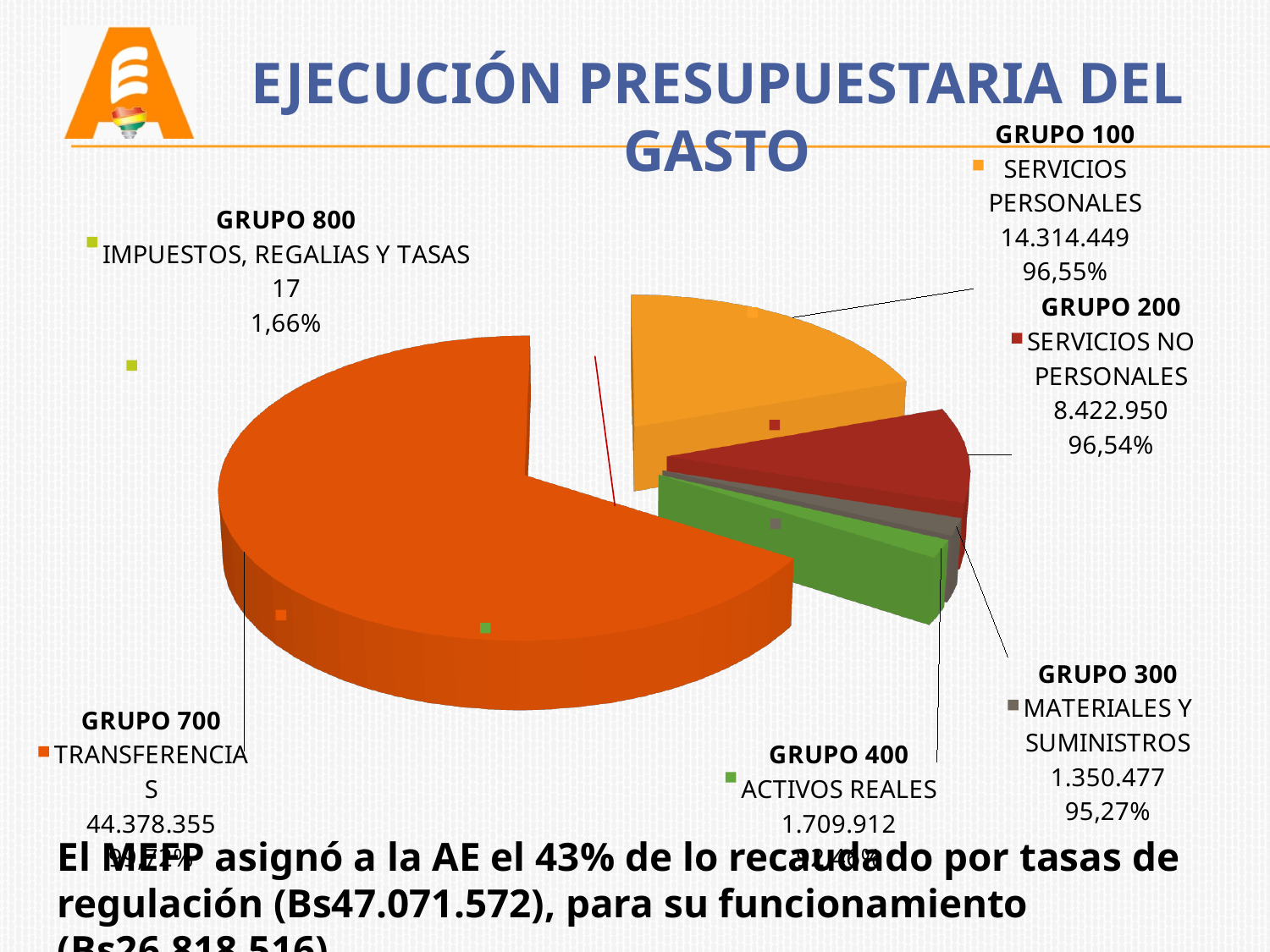
What amount is shown for GRUPO 200 SERVICIOS NO PERSONALES? 8.422.950 What percentage is shown for GRUPO 300 MATERIALES Y SUMINISTROS? 95,27% What amount is shown for GRUPO 300 MATERIALES Y SUMINISTROS? 1.350.477 Which group has the largest slice of the pie? GRUPO 700 TRANSFERENCIAS What kind of chart is shown on the slide? pie chart Which group has the smallest amount? GRUPO 800 IMPUESTOS, REGALIAS Y TASAS What amount is shown for GRUPO 700 TRANSFERENCIAS? 44.378.355 What percentage is shown for GRUPO 100 SERVICIOS PERSONALES? 96,55% What is the difference between the amounts for GRUPO 100 SERVICIOS PERSONALES and GRUPO 200 SERVICIOS NO PERSONALES? 5.891.499 What is the title of the chart? EJECUCIÓN PRESUPUESTARIA DEL GASTO What amount is shown for GRUPO 100 SERVICIOS PERSONALES? 14.314.449 How many groups (slices) does the pie chart show? 6